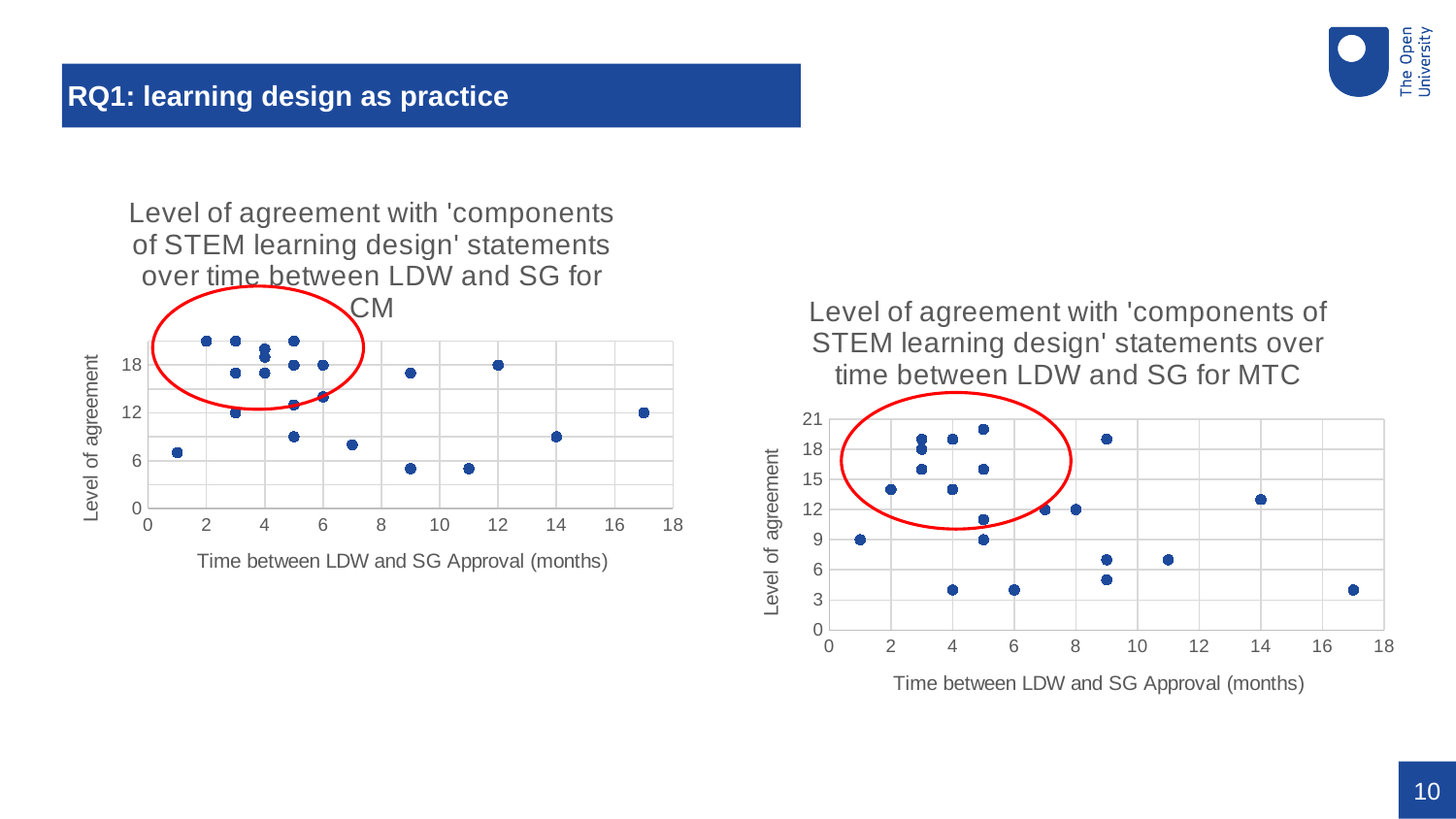
How many charts are shown on the slide? 2 In the right chart (MTC), what is the highest value shown on the y axis? 21 In the left chart (CM), which has the higher level of agreement: the point at 12 months or the point at 14 months? the point at 12 months In the left chart (CM), is the level of agreement for the point at 14 months greater or less than 12? less In the right chart (MTC), is the level of agreement for the point at 17 months greater or less than 6? less In the left chart (CM), is the level of agreement for the point at 12 months greater or less than 12? greater What kind of chart is the chart on the left, titled 'Level of agreement with components of STEM learning design statements over time between LDW and SG for CM'? scatter chart What kind of chart is the chart on the right, for MTC? scatter chart In the left chart (CM), what is the title of the x axis? Time between LDW and SG Approval (months) In the right chart (MTC), what is the title of the y axis? Level of agreement